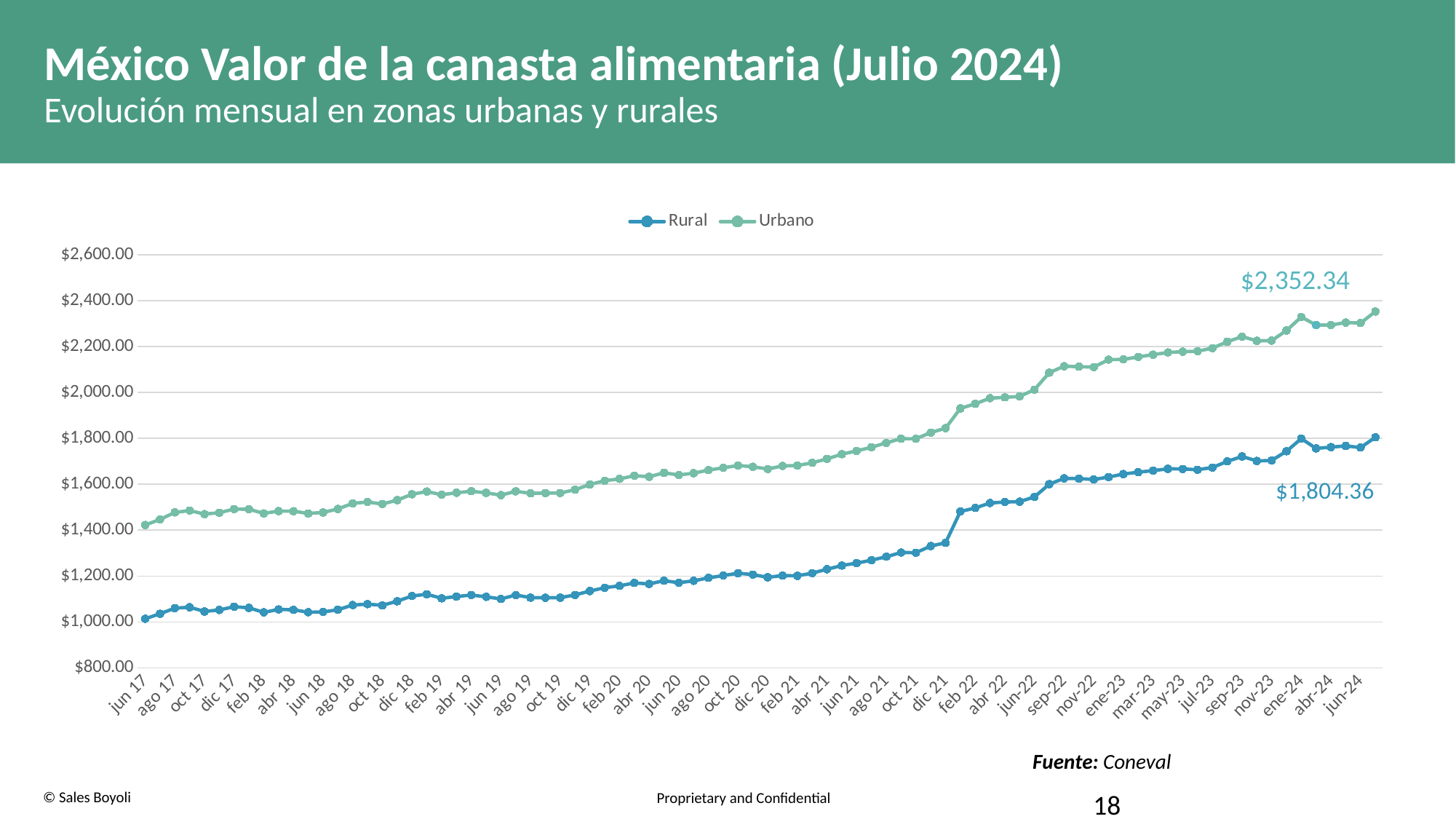
What kind of chart is shown on the slide? Line chart Is the Rural value for dic 21 greater or less than $1,400.00? less Which series is higher across the whole period shown? Urbano Is the Urbano value for feb 22 greater or less than $1,800.00? greater Do the values of the Urbano series rise or fall from jun 17 to jun 24? Rise What is the source cited for the chart? Coneval What is the latest labelled value for the Rural series? $1,804.36 How many series does the legend list? 2 Which series has the higher value at the end of the chart, Rural or Urbano? Urbano What is the latest labelled value for the Urbano series? $2,352.34 Is the Rural value for jun 17 greater or less than $1,200.00? less What is the difference between the labelled Urbano value ($2,352.34) and the labelled Rural value ($1,804.36)? $547.98